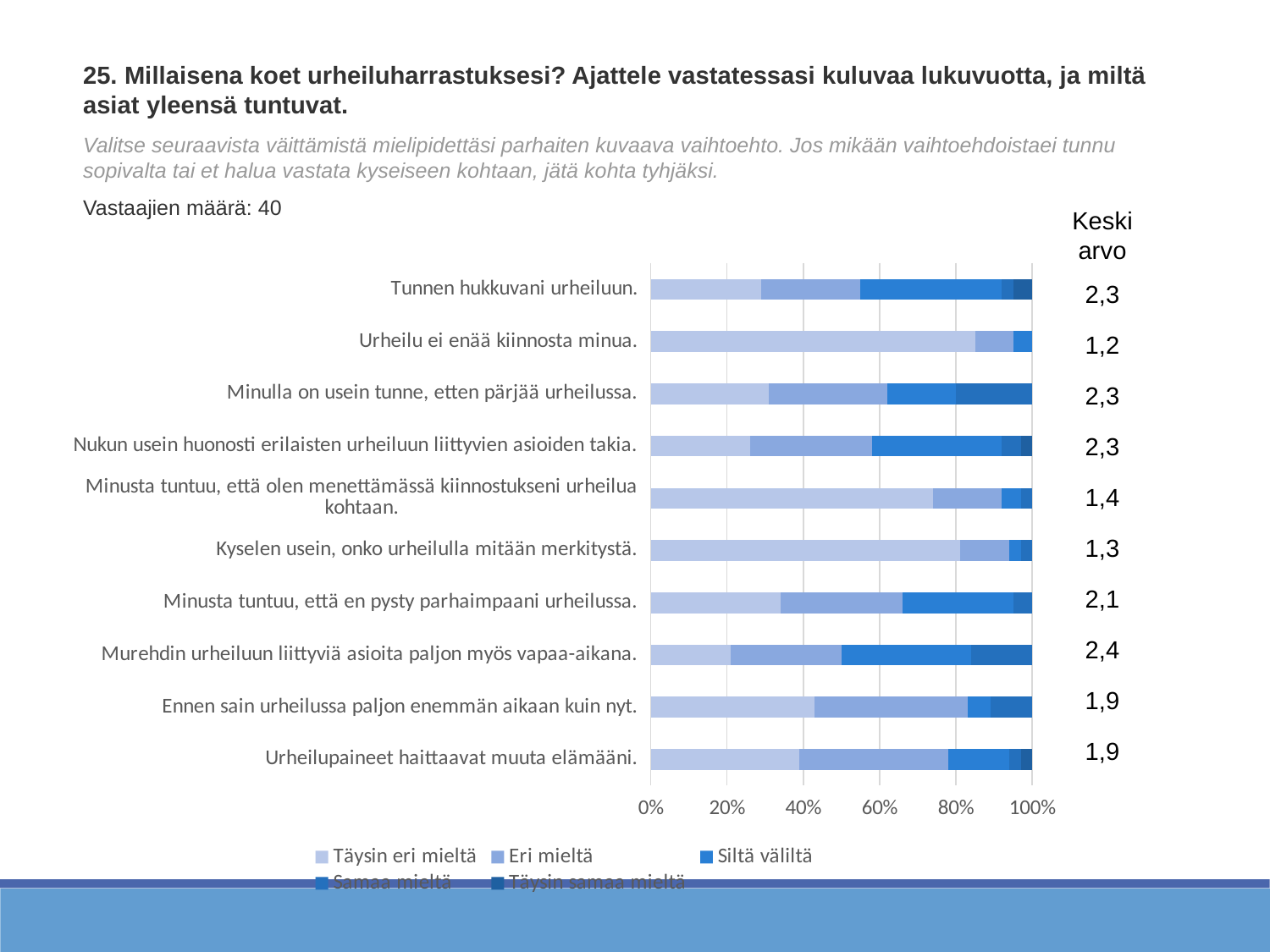
Which statement has the highest Keskiarvo (mean) value? Murehdin urheiluun liittyviä asioita paljon myös vapaa-aikana. What is the Keskiarvo (mean) value shown for "Urheilu ei enää kiinnosta minua."? 1,2 Which statement has the lowest Keskiarvo (mean) value? Urheilu ei enää kiinnosta minua. What kind of chart is shown on the slide? Stacked bar chart What is the difference between the highest and lowest Keskiarvo values shown? 1,2 Is the "Täysin eri mieltä" share for "Urheilu ei enää kiinnosta minua." greater or less than 80%? greater How many statements (categories) are plotted in the chart? 10 What is the Keskiarvo (mean) value shown for "Murehdin urheiluun liittyviä asioita paljon myös vapaa-aikana."? 2,4 What is the Keskiarvo (mean) value shown for "Minusta tuntuu, että en pysty parhaimpaani urheilussa."? 2,1 How many respondents (Vastaajien määrä) does the slide report? 40 Which has a larger Keskiarvo value: "Minusta tuntuu, että en pysty parhaimpaani urheilussa." or "Ennen sain urheilussa paljon enemmän aikaan kuin nyt."? Minusta tuntuu, että en pysty parhaimpaani urheilussa. How many series does the chart legend list? 5